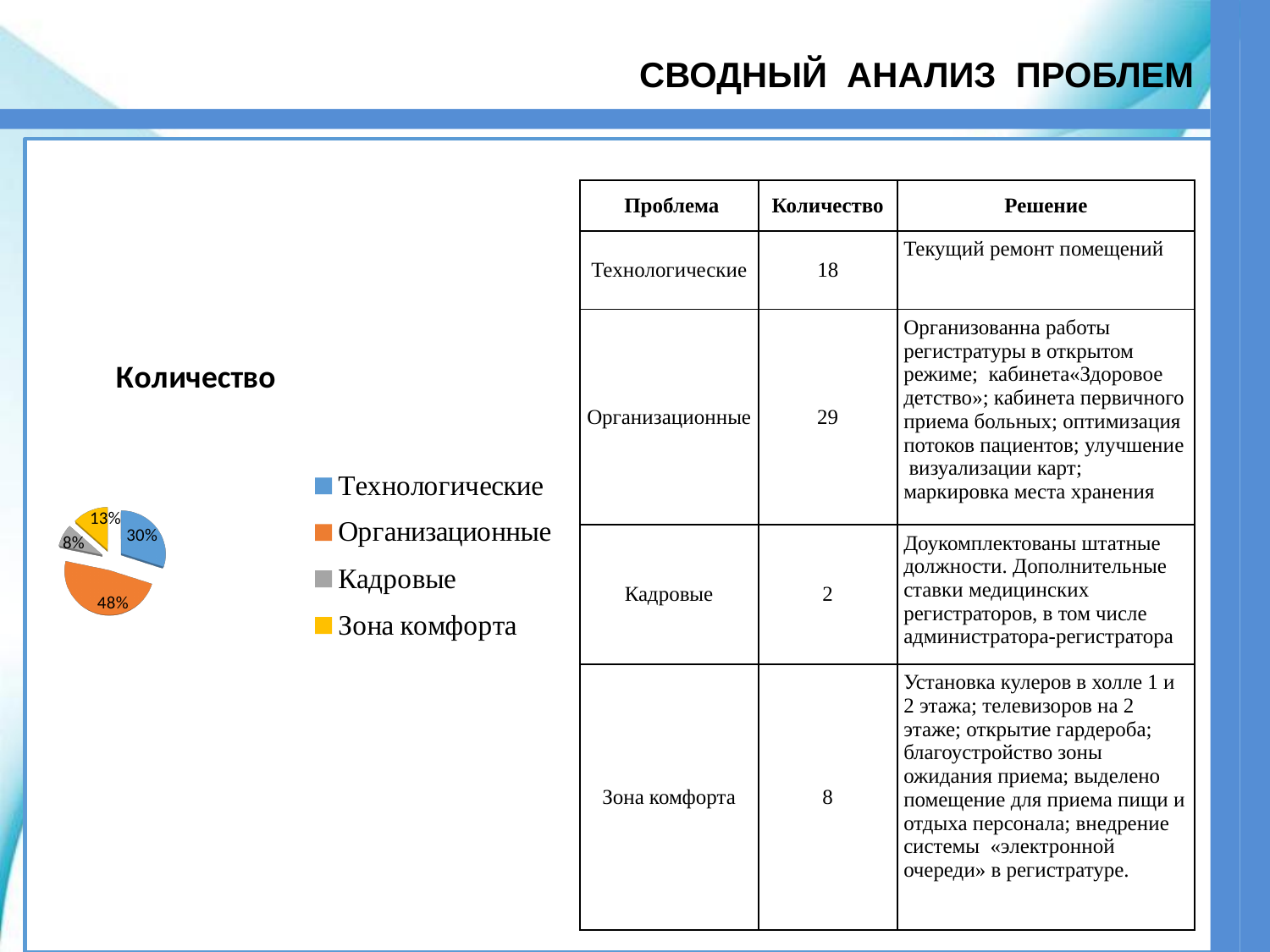
What share of the pie does Зона комфорта have? 13% What is the title of the pie chart? Количество What kind of chart is shown on the slide? pie chart How many slices does the pie chart have? 4 Which is larger in the pie chart: Технологические or Зона комфорта? Технологические What share of the pie does Технологические have? 30% What is the difference in percentage points between the Организационные and Технологические slices? 18% Which category has the largest slice of the pie chart? Организационные What share of the pie does Кадровые have? 8% How many entries does the legend of the pie chart list? 4 Which category has the smallest slice of the pie chart? Кадровые